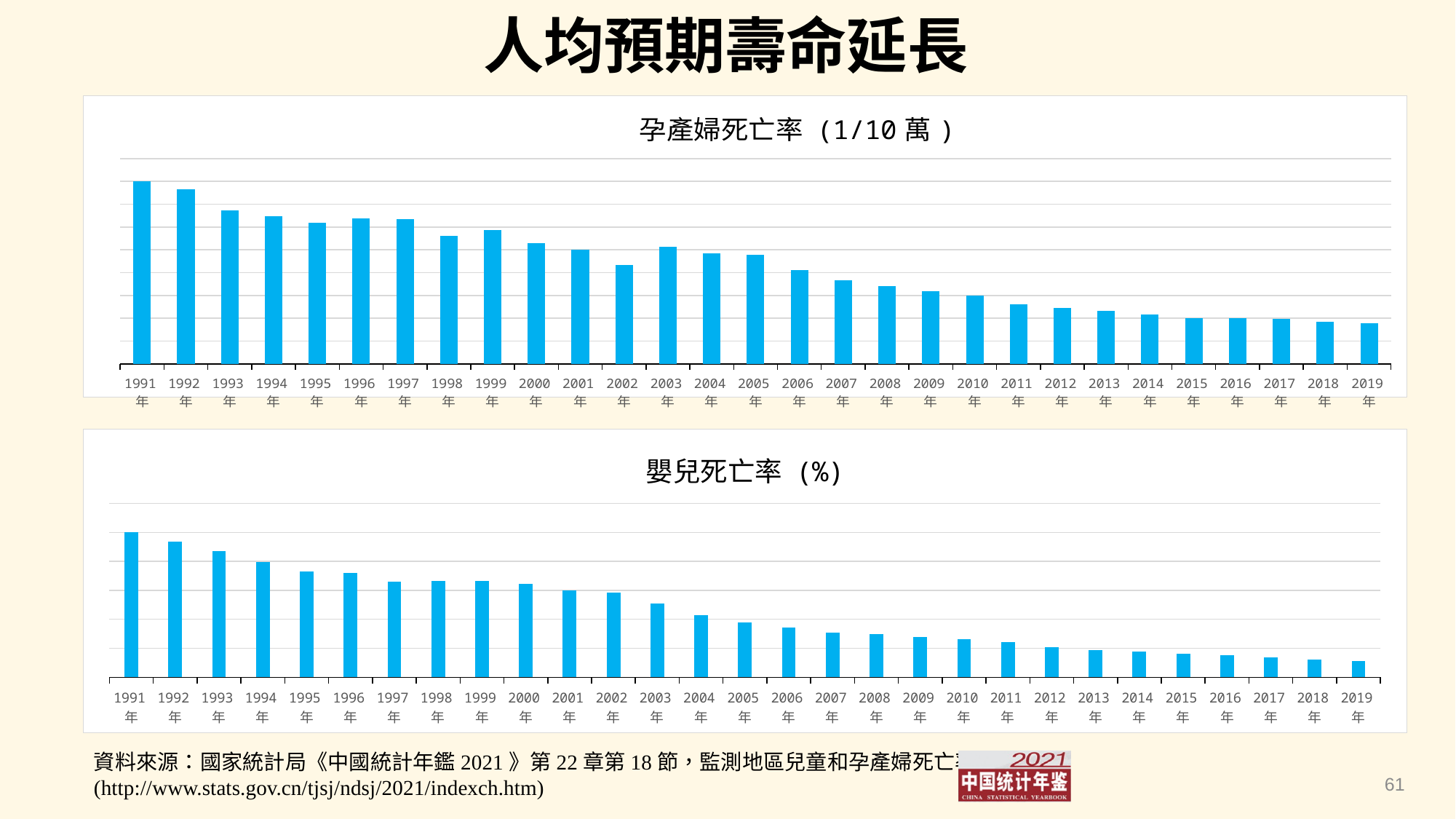
In the bottom chart (嬰兒死亡率), which is larger, the value for 2003年 or 2004年? 2003年 What kind of chart is the top chart titled 孕產婦死亡率（1/10萬）? bar chart In the top chart (孕產婦死亡率), which is larger, the value for 2002年 or 2003年? 2003年 In the top chart (孕產婦死亡率), which year has the highest value? 1991年 What is the title of the bottom chart on the slide? 嬰兒死亡率（%） What is the title of the top chart on the slide? 孕產婦死亡率（1/10萬） In the bottom chart (嬰兒死亡率), which year has the highest value? 1991年 How many years are plotted in the top chart (孕產婦死亡率)? 29 How many years are plotted in the bottom chart (嬰兒死亡率)? 29 What kind of chart is the bottom chart titled 嬰兒死亡率（%）? bar chart In the top chart (孕產婦死亡率), do the values generally rise or fall from 1991 to 2019? fall In the bottom chart (嬰兒死亡率), do the values generally rise or fall from 1991 to 2019? fall